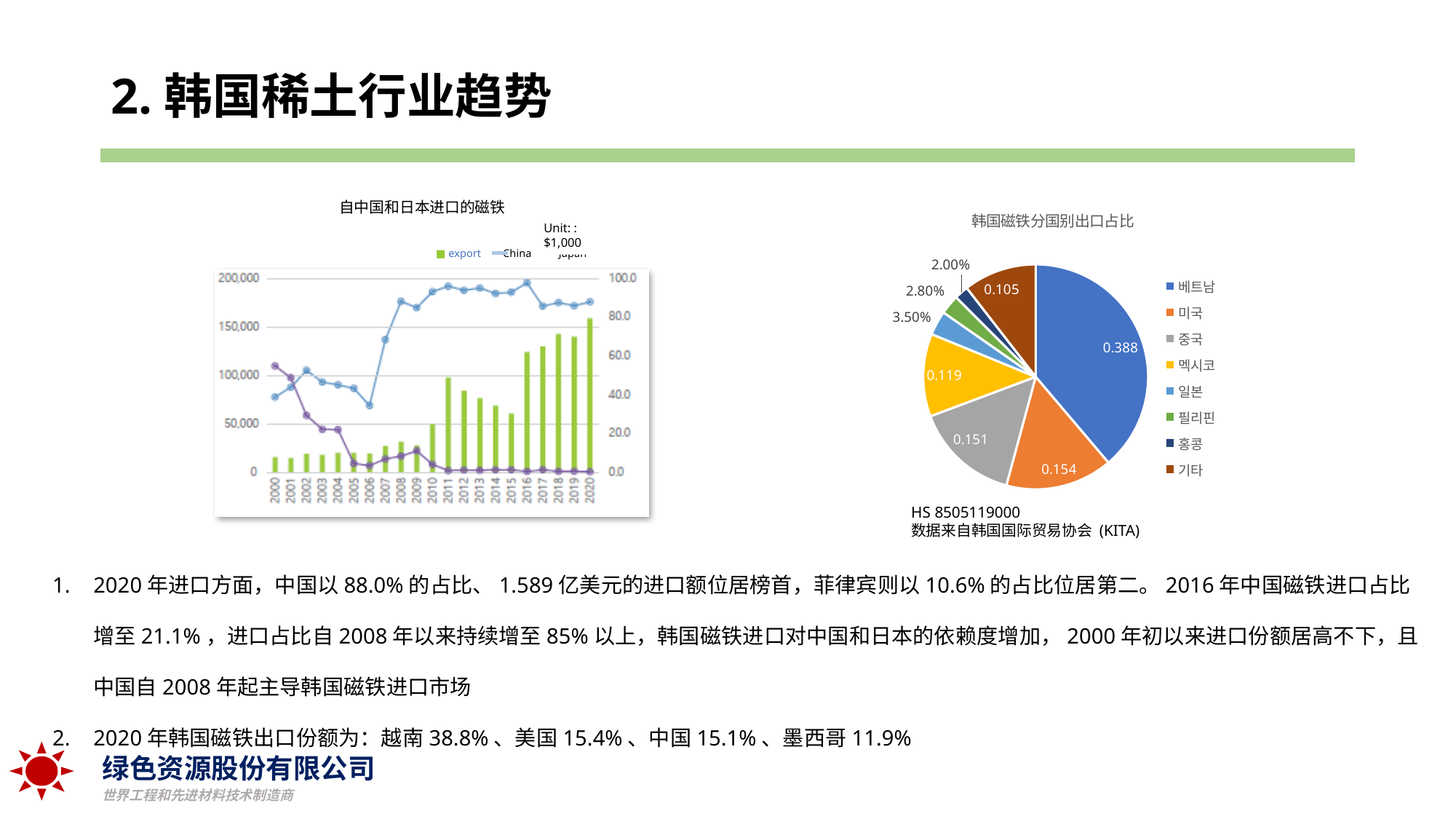
In the left chart 自中国和日本进口的磁铁, is the export bar for 2020 greater or less than 150,000? greater In the pie chart 韩国磁铁分国别出口占比, what is the value shown for 일본? 3.50% How many series does the legend of the left chart 自中国和日本进口的磁铁 list? 3 In the pie chart 韩国磁铁分国别出口占比, what is the difference between the values for 미국 and 중국? 0.003 In the pie chart 韩国磁铁分国别出口占比, which country has the largest slice? 베트남 In the pie chart 韩国磁铁分国别出口占比, which category has the smallest slice? 홍콩 How many categories does the legend of the pie chart 韩国磁铁分国别出口占比 list? 8 In the pie chart 韩国磁铁分国别出口占比, which is larger, the slice for 멕시코 or the slice for 기타? 멕시코 In the left chart 自中国和日本进口的磁铁, does the Japan line rise or fall from 2000 to 2020? fall In the pie chart 韩国磁铁分国别出口占比, what is the value shown for 베트남? 0.388 What kind of chart is the left chart titled 自中国和日本进口的磁铁? Combined bar and line chart In the pie chart 韩国磁铁分国别出口占比, what is the value shown for 멕시코? 0.119